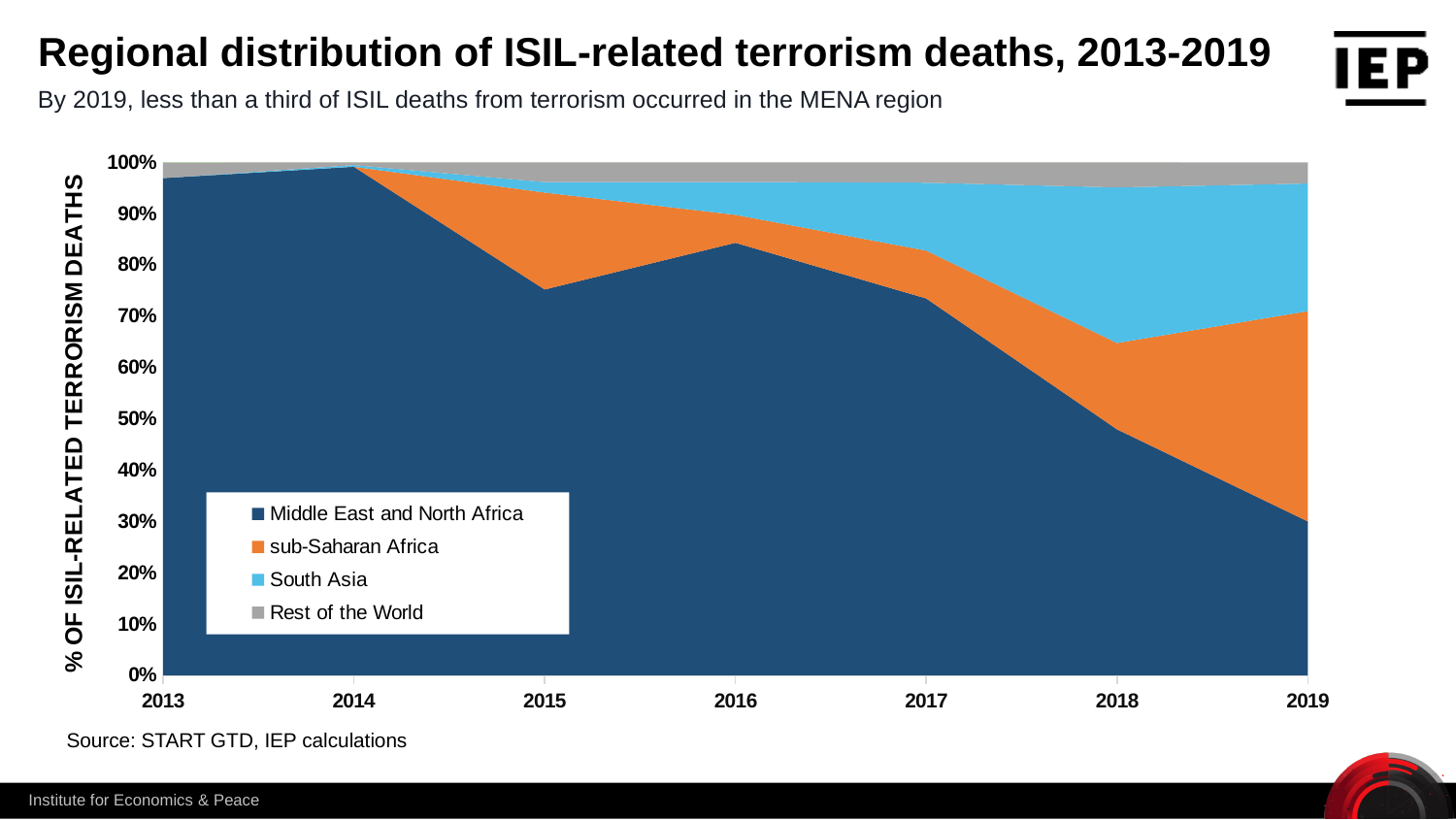
Does the share of ISIL-related terrorism deaths for Middle East and North Africa rise or fall overall from 2013 to 2019? fall What is the label on the y axis? % OF ISIL-RELATED TERRORISM DEATHS Which series is shown in dark blue in the legend? Middle East and North Africa How many years are shown along the x axis? 7 Is the share of ISIL-related terrorism deaths for Middle East and North Africa in 2019 greater or less than 40%? less Is the share of ISIL-related terrorism deaths for Middle East and North Africa in 2015 greater or less than 80%? less How many series does the legend list? 4 Is the share of ISIL-related terrorism deaths for Middle East and North Africa in 2018 greater or less than 40%? greater Is the share for Middle East and North Africa larger in 2015 or in 2016? 2016 In which year is the share of ISIL-related terrorism deaths for Middle East and North Africa lowest? 2019 What kind of chart is shown on the slide? Stacked area chart